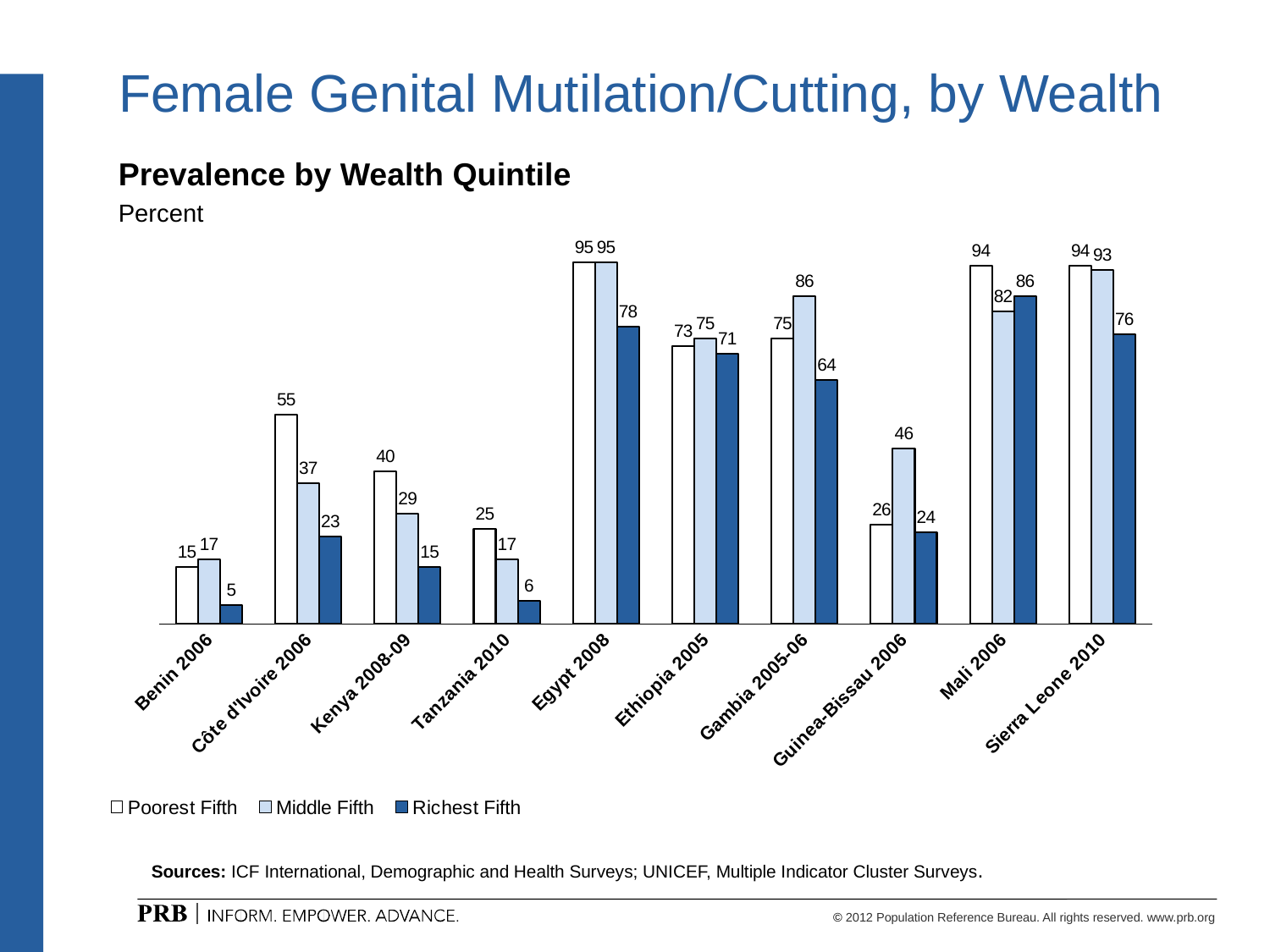
Which is larger for Gambia 2005-06: the Middle Fifth value or the Poorest Fifth value? Middle Fifth How many countries are shown on the x axis? 10 What is the Richest Fifth value for Sierra Leone 2010? 76 What is the Richest Fifth value for Benin 2006? 5 Which country has the highest Poorest Fifth value? Egypt 2008 What is the difference between the Poorest Fifth and Richest Fifth values for Kenya 2008-09? 25 Which series is shown in the darkest blue colour in the legend? Richest Fifth How many series does the legend list? 3 What kind of chart is shown on the slide? Bar chart What is the Poorest Fifth value for Côte d'Ivoire 2006? 55 What is the Middle Fifth value for Guinea-Bissau 2006? 46 Which country has the lowest Richest Fifth value? Benin 2006